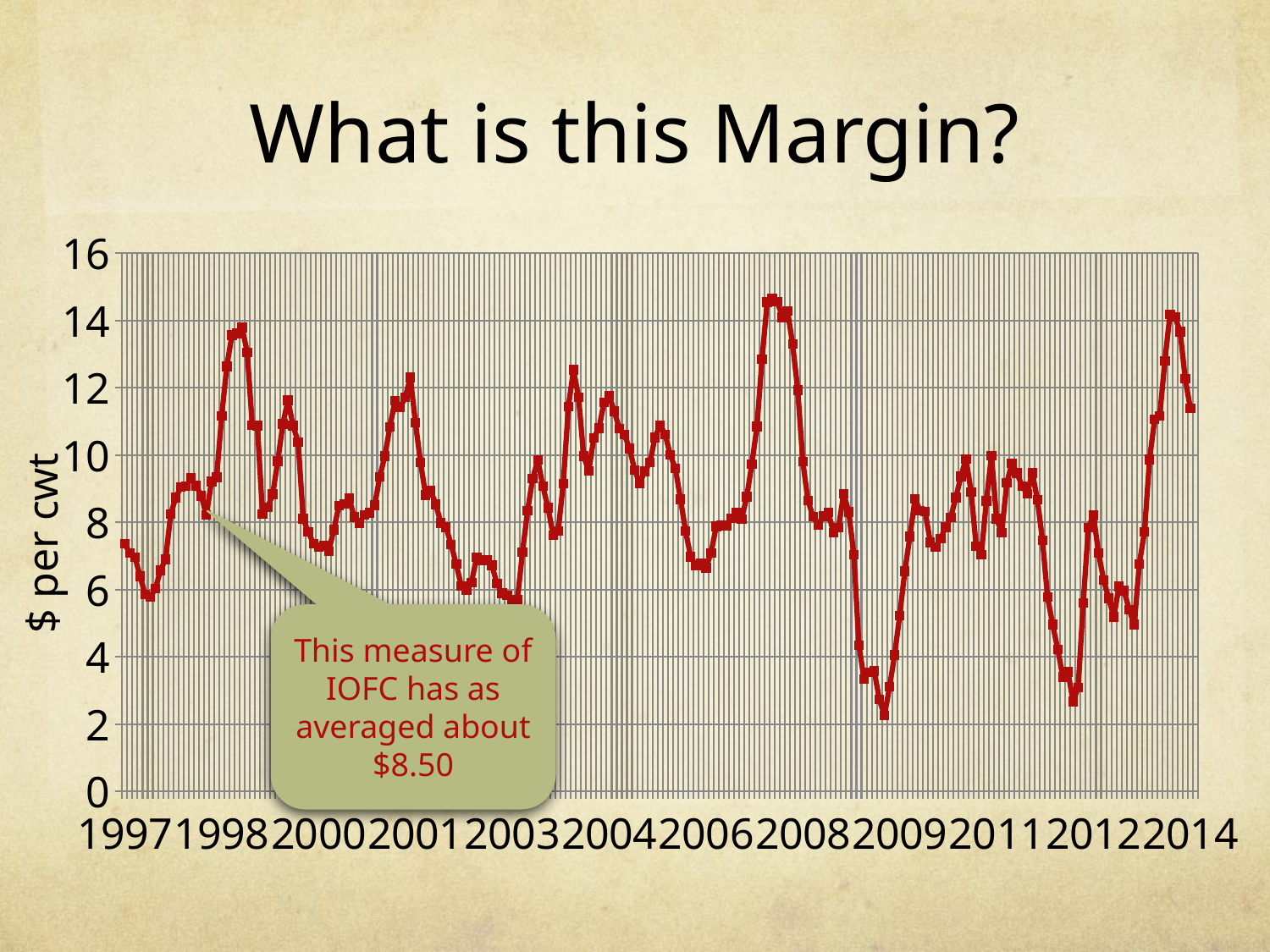
Is the first value of the series at 1997 greater or less than 8? less According to the callout on the chart, what has this measure of IOFC averaged? about $8.50 What is the title of the vertical axis? $ per cwt Is the highest peak of the series, just before the 2008 label, greater or less than 14? greater Does the series rise or fall between its peak just before 2008 and the 2009 label? fall How many data series are plotted on the chart? 1 Around which labeled year does the series reach its highest value? 2008 Which is higher: the peak just before the 2008 label or the peak near the 2004 label? the peak just before 2008 Is the low point of the series near the 2012 label greater or less than 4? less What kind of chart is shown on the slide? line chart